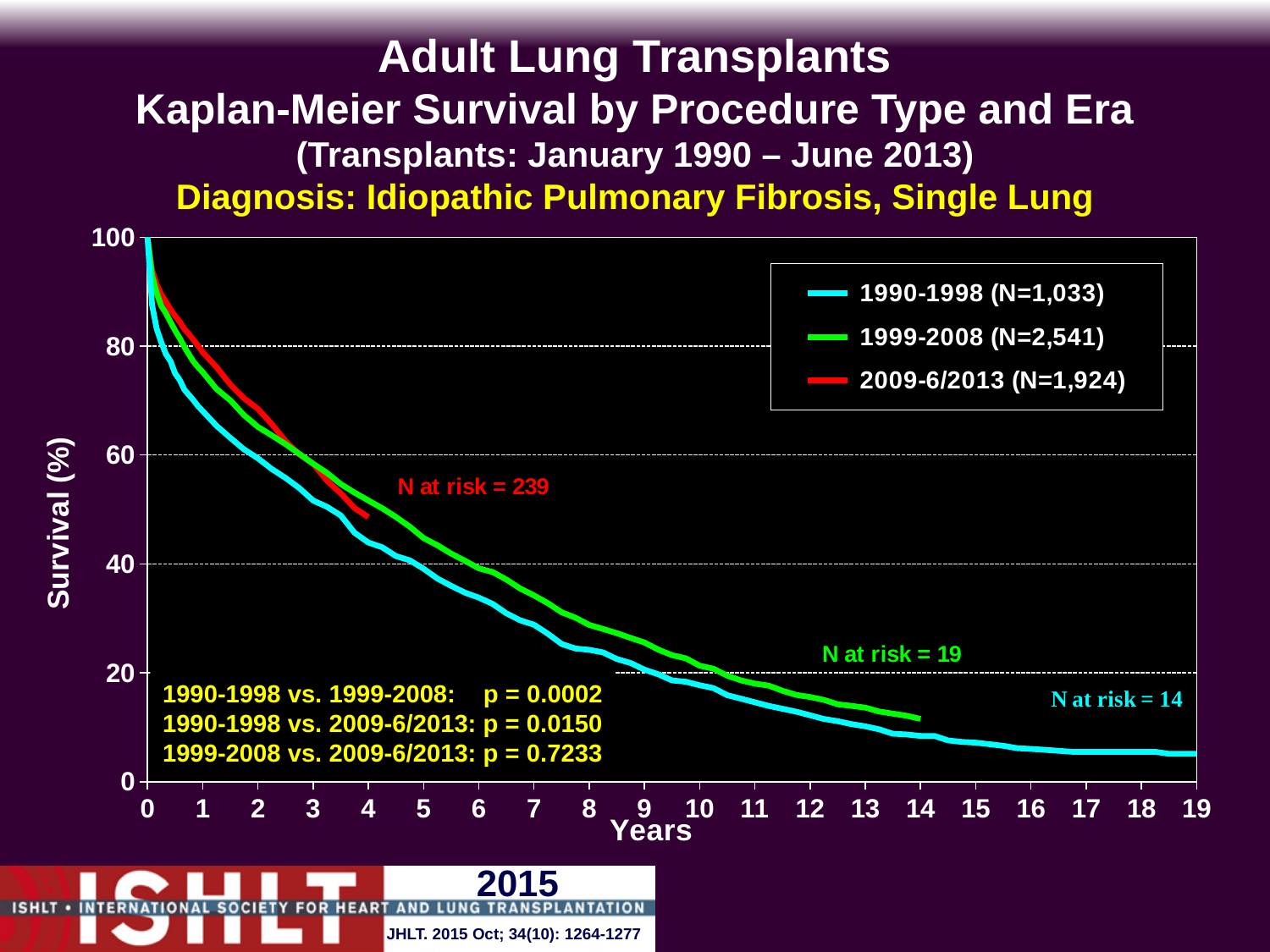
Is the survival for the 1999-2008 era at 5 years greater or less than 40? greater Which era's curve extends to the longest follow-up on the x axis? 1990-1998 At 5 years, which era has higher survival: 1990-1998 or 1999-2008? 1999-2008 What kind of chart is shown on the slide? line chart Do the survival curves rise or fall as years increase? fall Is the survival for the 1990-1998 era at 10 years greater or less than 20? less What is the N at risk printed for the 1990-1998 (cyan) curve? 14 What is the N at risk printed for the 2009-6/2013 (red) curve? 239 What is the N for the 1999-2008 era shown in the legend? N=2,541 How many series does the legend list? 3 What is the p-value for 1990-1998 vs. 1999-2008? p = 0.0002 What is the N for the 2009-6/2013 era shown in the legend? N=1,924